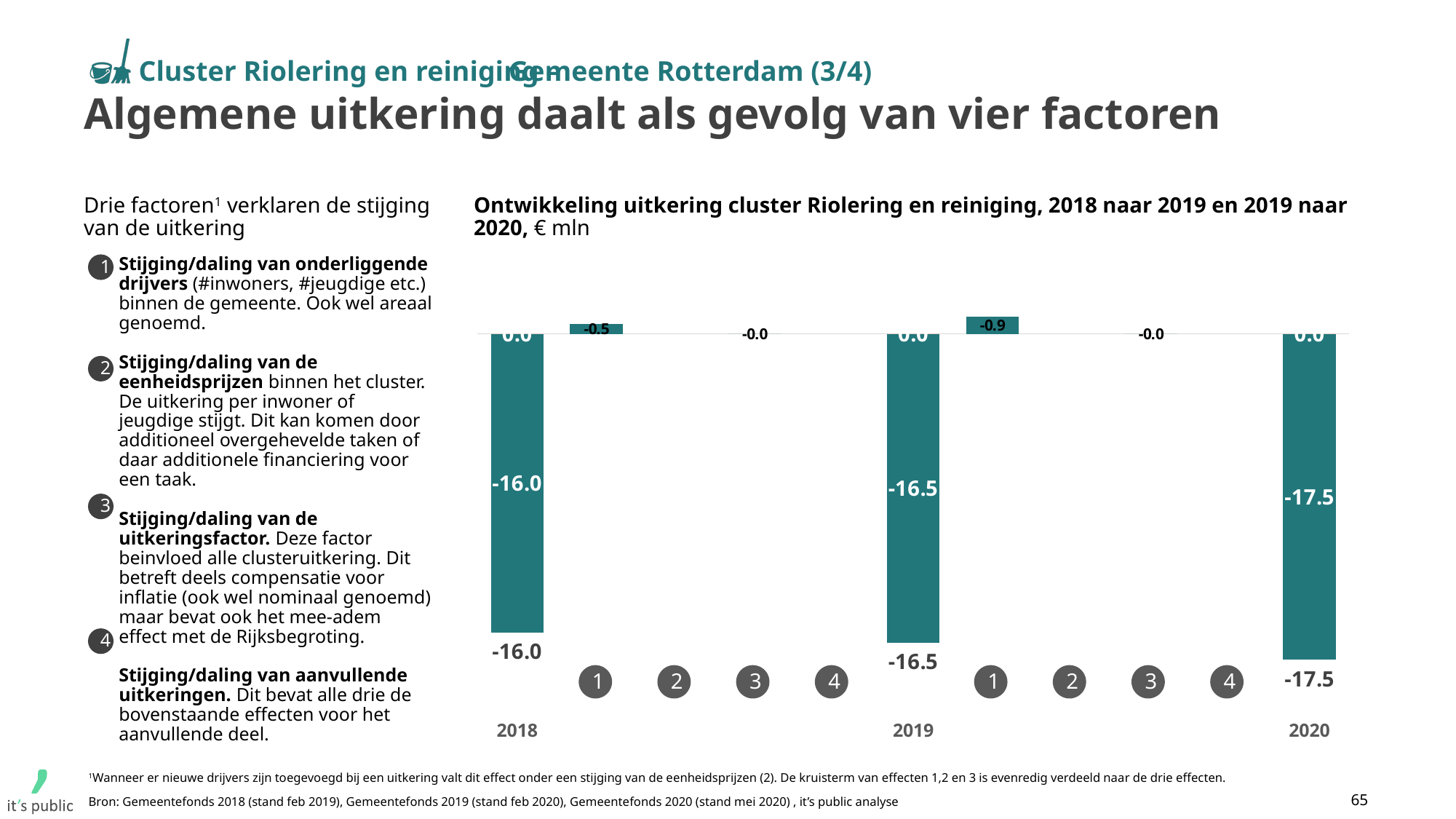
What kind of chart is shown? bar chart What is the value of the uitkering for 2018? -16.0 What is the value of factor 1 in the change from 2019 to 2020? -0.9 Which year has the lowest (most negative) uitkering value? 2020 What is the value of the uitkering for 2019? -16.5 What is the difference between the 2020 value and the 2019 value? -1.0 In what unit are the values in the chart expressed? € mln What is the value of factor 1 in the change from 2018 to 2019? -0.5 What is the value of the uitkering for 2020? -17.5 Which year has the highest (least negative) uitkering value? 2018 Which factor 1 effect is larger in magnitude: 2018 to 2019 or 2019 to 2020? 2019 to 2020 Do the year values rise or fall from 2018 to 2020? fall